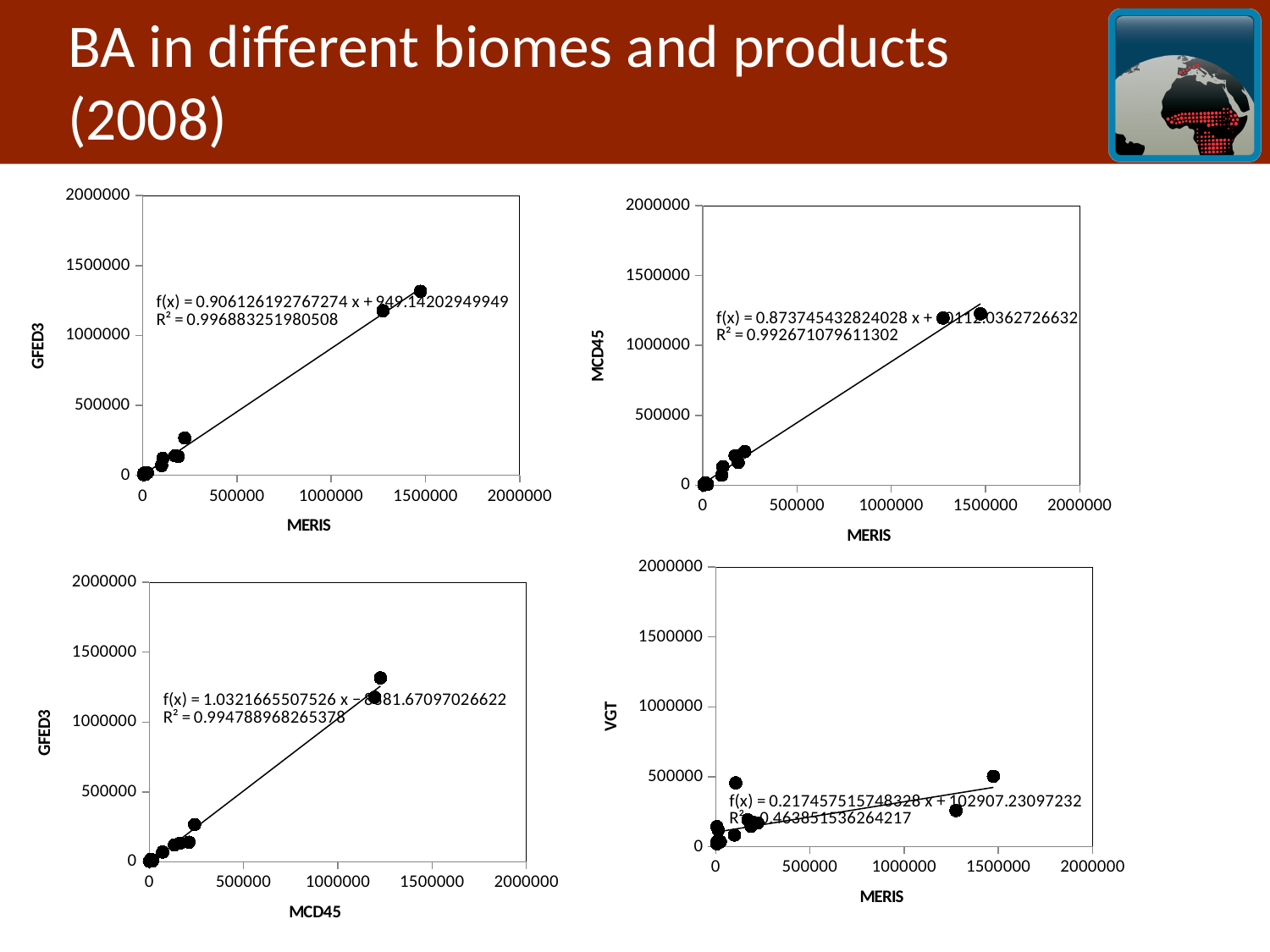
In the bottom-right chart (VGT vs MERIS), is the highest plotted VGT value greater or less than 1000000? less Which of the four charts has the lowest R² value? the bottom-right chart (VGT vs MERIS) In the top-left chart (GFED3 vs MERIS), what is the R² value printed on the chart? 0.996883251980508 What kind of chart is the top-left chart (GFED3 vs MERIS)? scatter chart How many charts are shown on the slide? 4 In the bottom-left chart (GFED3 vs MCD45), what is the R² value printed on the chart? 0.994788968265378 What is the x-axis label of the bottom-left chart? MCD45 In the bottom-right chart (VGT vs MERIS), what is the slope of the fitted line f(x)? 0.217457515748328 In the top-right chart (MCD45 vs MERIS), what is the R² value printed on the chart? 0.992671079611302 In the top-left chart (GFED3 vs MERIS), what is the slope of the fitted line f(x)? 0.906126192767274 In the bottom-left chart (GFED3 vs MCD45), what is the slope of the fitted line f(x)? 1.0321665507526 In the top-left chart (GFED3 vs MERIS), is the highest plotted GFED3 value greater or less than 1000000? greater